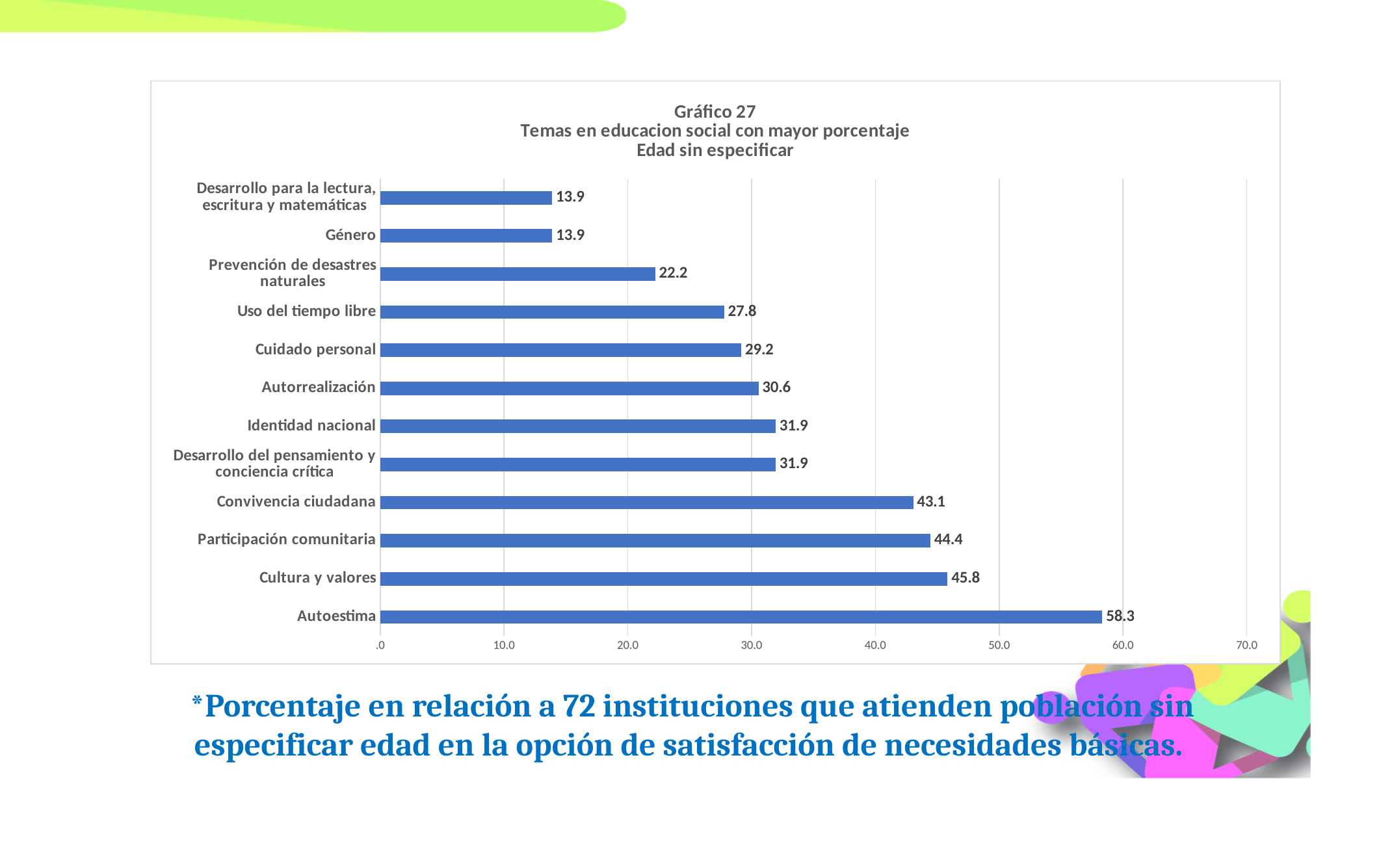
What is the difference between the values for Autoestima and Cultura y valores? 12.5 What is the number of the chart given in its title? Gráfico 27 Is the value for Convivencia ciudadana greater or less than 40.0? greater What is the value for Prevención de desastres naturales? 22.2 What is the value for Autoestima? 58.3 What is the value for Cultura y valores? 45.8 What kind of chart is shown on the slide? bar chart Which category has the highest value? Autoestima How many categories are shown in the chart? 12 Which is larger, the value for Uso del tiempo libre or the value for Autorrealización? Autorrealización What is the value for Cuidado personal? 29.2 What is the difference between the values for Participación comunitaria and Convivencia ciudadana? 1.3